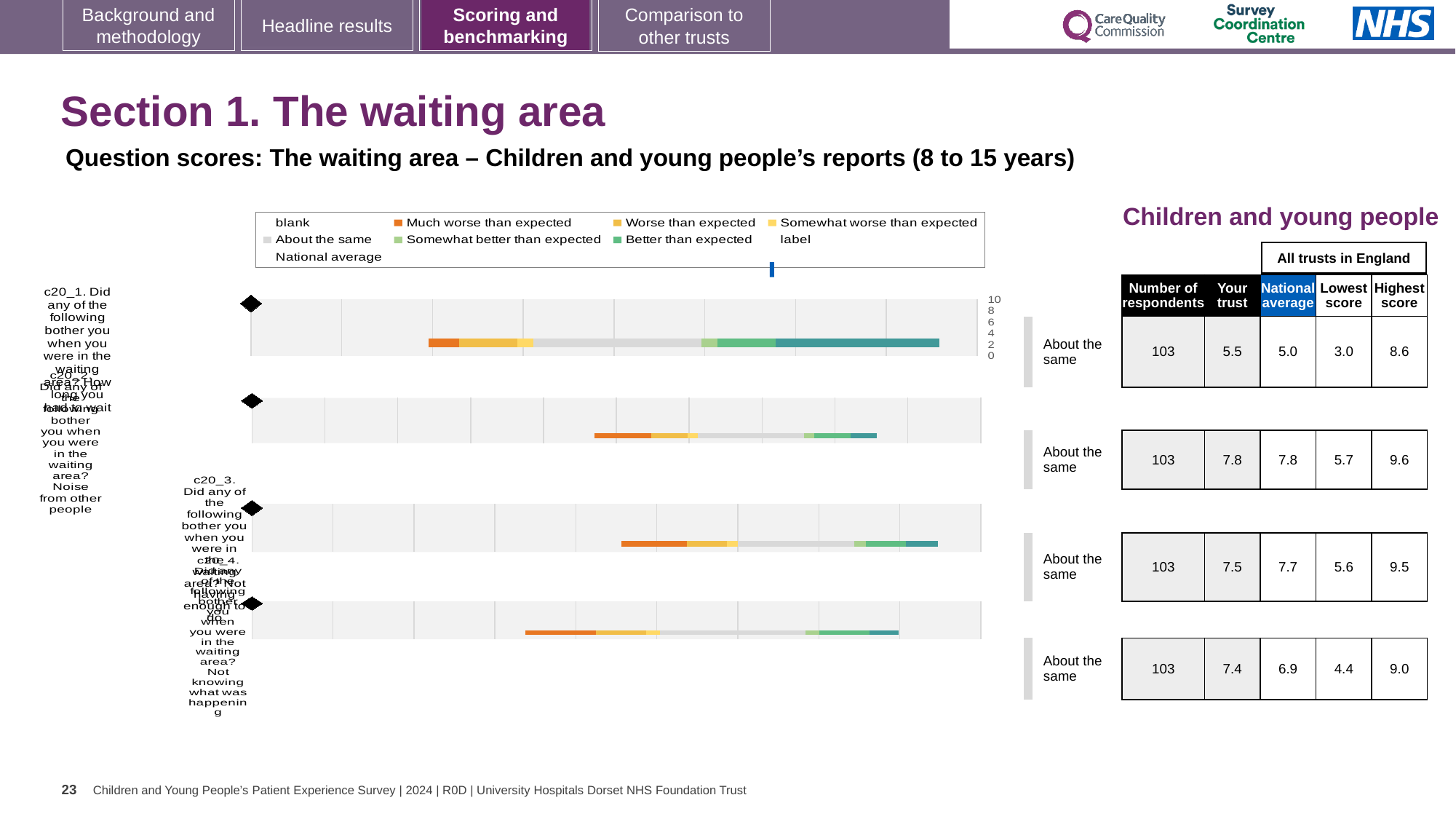
For the fourth (bottom) bar chart, what is the difference between the 'Your trust' score (7.4) and the national average (6.9)? 0.5 For the third bar chart, what is the highest score across all trusts in England? 9.5 How many question bar charts are shown on the slide? 4 What colour does the legend use for 'Much worse than expected'? Orange What is the highest value shown on the score axis above the first bar chart? 10 What kind of chart is used to show the question scores on this slide? Bar chart Which of the four bar charts has the highest 'Your trust' score? The second chart (7.8) For the first (top) bar chart, what is the 'Your trust' score shown in the table? 5.5 For the fourth (bottom) bar chart, which is larger: the 'Your trust' score or the national average? Your trust For the fourth (bottom) bar chart, what is the lowest score across all trusts in England? 4.4 For the second bar chart, what is the national average score shown in the table? 7.8 What benchmark label is shown next to each of the four bar charts? About the same